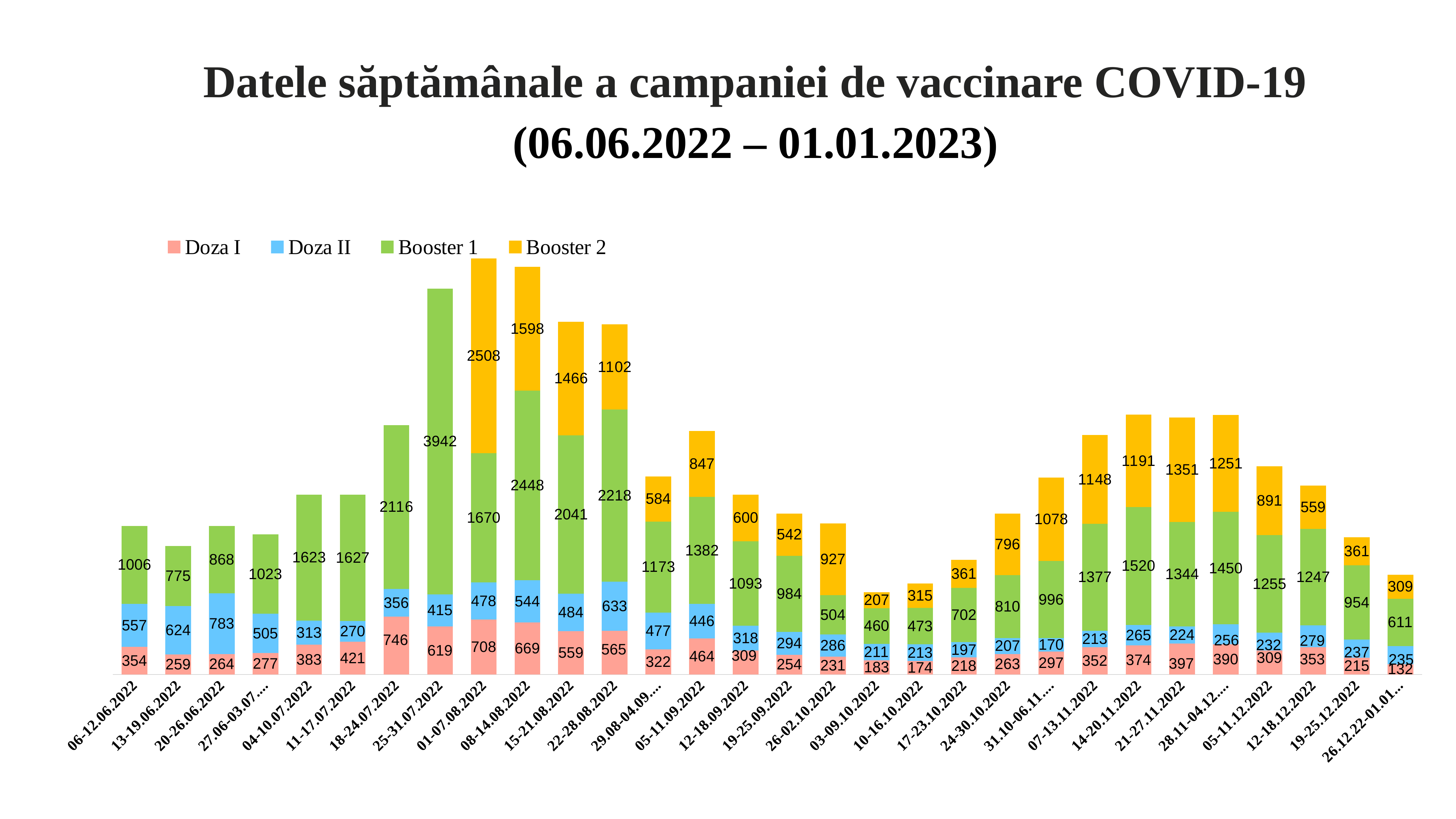
How many series does the legend list? 4 How many weekly categories are plotted along the x axis? 30 What is the difference between the Booster 2 values for 01-07.08.2022 and 08-14.08.2022? 910 What is the Booster 2 value for the week 21-27.11.2022? 1351 What is the total of the stacked bar for the week 03-09.10.2022? 1061 Which series is shown in yellow in the legend? Booster 2 What is the Booster 1 value for the week 25-31.07.2022? 3942 What is the Doza II value for the week 22-28.08.2022? 633 Which week has the highest Booster 2 value? 01-07.08.2022 What type of chart is shown on the slide? Stacked bar chart Which is larger: the Booster 1 value for 14-20.11.2022 or for 28.11-04.12? 14-20.11.2022 Which week has the highest Doza I value? 18-24.07.2022